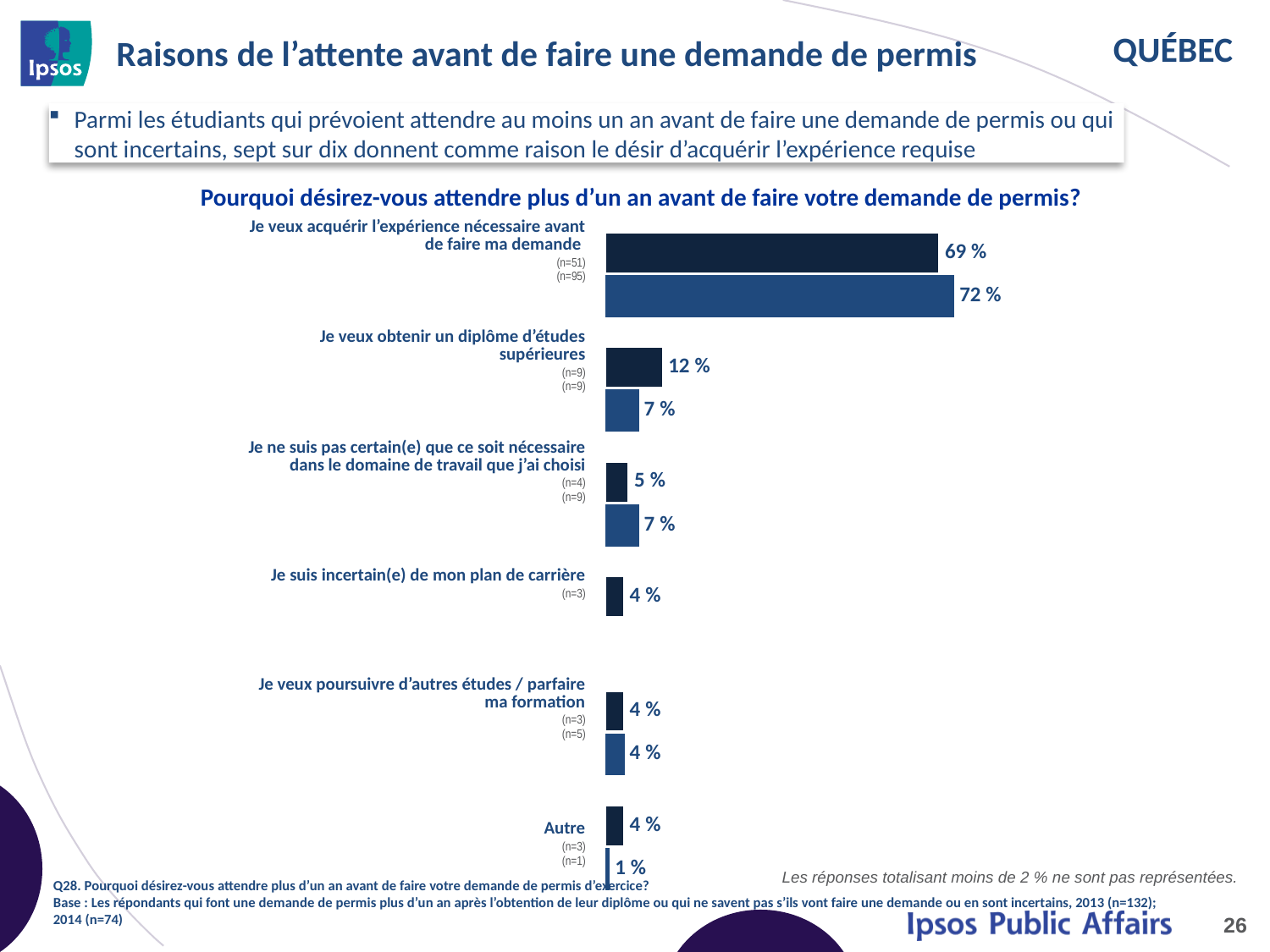
What is the value of the light blue bar for "Je veux acquérir l'expérience nécessaire avant de faire ma demande"? 72 % Which category has the highest value in the chart? Je veux acquérir l'expérience nécessaire avant de faire ma demande How many response categories are shown in the chart? 6 What is the difference between the dark blue bar and the light blue bar for "Je veux obtenir un diplôme d'études supérieures"? 5 % What is the value of the dark blue bar for "Je veux obtenir un diplôme d'études supérieures"? 12 % What is the value of the light blue bar for "Je ne suis pas certain(e) que ce soit nécessaire dans le domaine de travail que j'ai choisi"? 7 % For "Je veux obtenir un diplôme d'études supérieures", which bar is larger, the dark blue or the light blue? dark blue What is the value of the light blue bar for "Autre"? 1 % What is the difference between the light blue bar and the dark blue bar for "Je veux acquérir l'expérience nécessaire avant de faire ma demande"? 3 % What is the title of the chart? Pourquoi désirez-vous attendre plus d'un an avant de faire votre demande de permis? What is the value of the dark blue bar for "Je veux acquérir l'expérience nécessaire avant de faire ma demande"? 69 % What type of chart is shown on the slide? bar chart